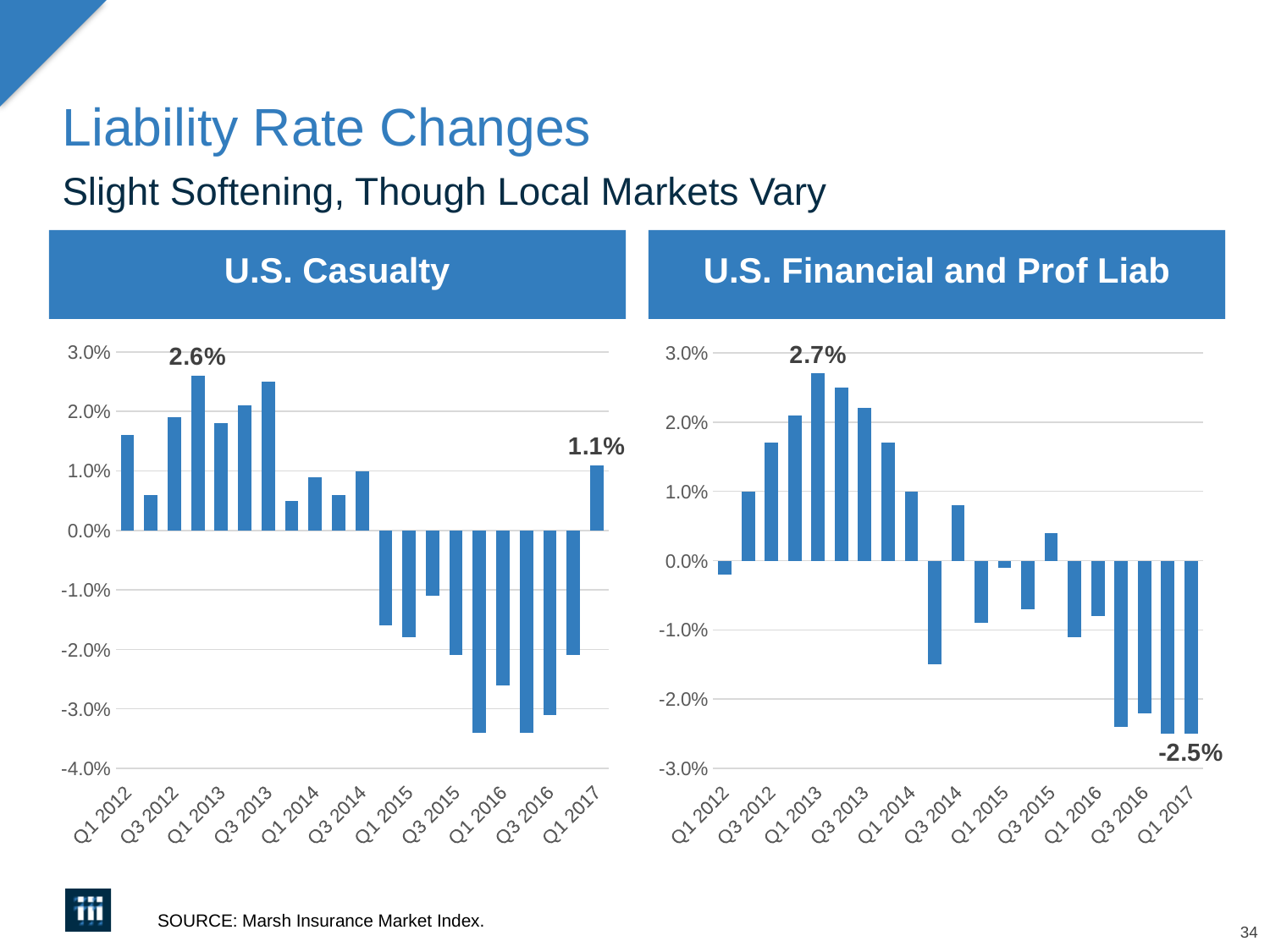
How many bars are plotted in the U.S. Casualty chart? 21 Which chart shows the larger value for Q1 2017, U.S. Casualty or U.S. Financial and Prof Liab? U.S. Casualty In the U.S. Casualty chart, what is the highest value shown? 2.6% In the U.S. Financial and Prof Liab chart, do the values rise or fall from Q1 2013 to Q1 2014? fall In the U.S. Financial and Prof Liab chart, what is the value for Q1 2017? -2.5% In the U.S. Financial and Prof Liab chart, what is the highest value shown? 2.7% What kind of chart is the U.S. Casualty chart? bar chart In the U.S. Casualty chart, what is the value for Q1 2017? 1.1% What source is cited for the charts on the slide? Marsh Insurance Market Index In the U.S. Financial and Prof Liab chart, is the value for Q3 2014 greater or less than -1.0%? greater What is the difference between the peak value in the U.S. Financial and Prof Liab chart (2.7%) and the peak value in the U.S. Casualty chart (2.6%)? 0.1 percentage points In the U.S. Casualty chart, is the value for Q1 2012 greater or less than 1.0%? greater